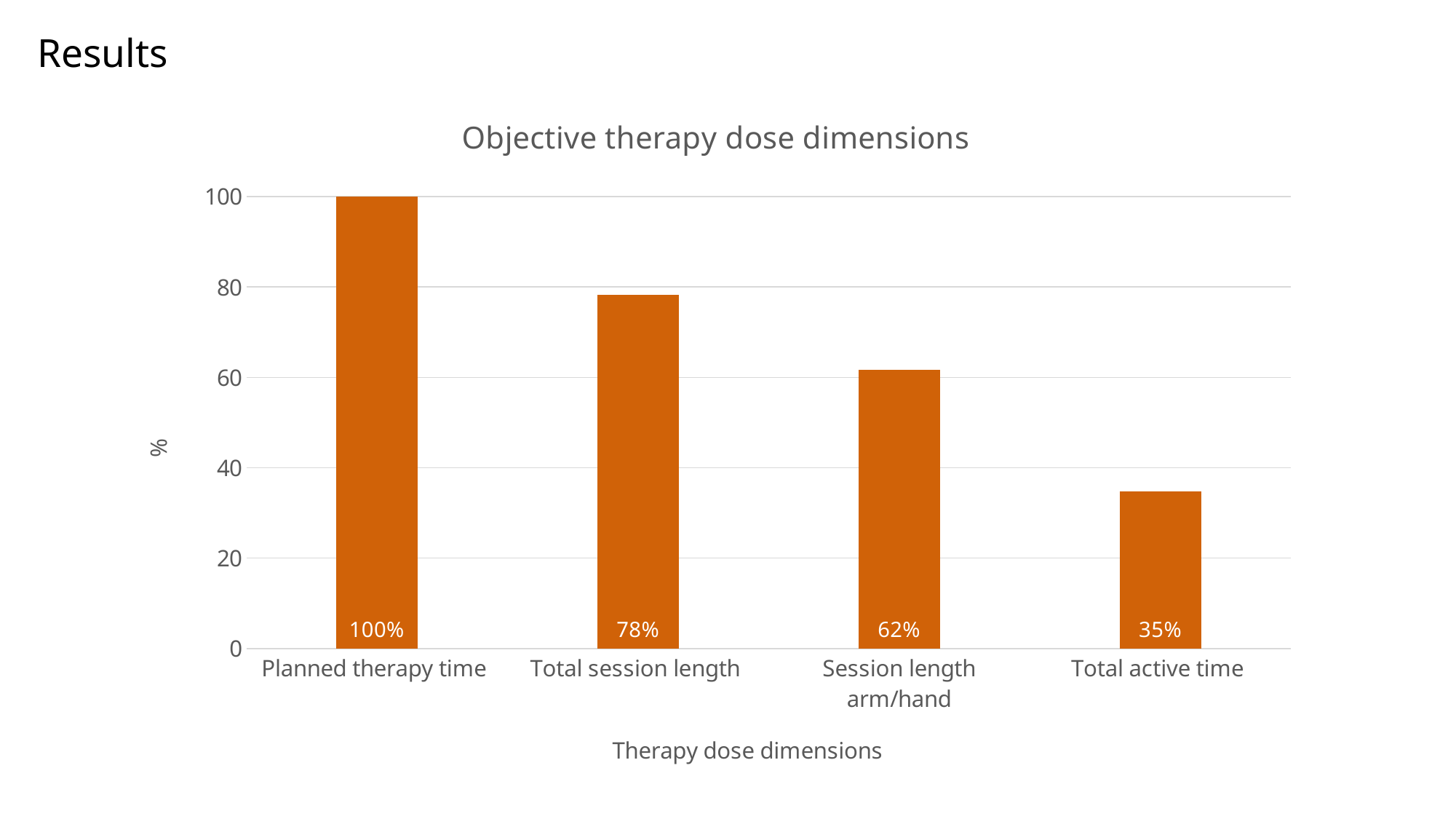
How many categories are shown on the x axis? 4 What is the value for Total active time? 35% What is the value for Session length arm/hand? 62% Which category has the highest value? Planned therapy time What is the value for Total session length? 78% What is the title of the chart? Objective therapy dose dimensions Which category has the lowest value? Total active time What is the difference between Planned therapy time and Session length arm/hand? 38% What kind of chart is shown? Bar chart Is the value for Total active time greater or less than 40? less What is the difference between Total session length and Total active time? 43% Which is larger, Session length arm/hand or Total active time? Session length arm/hand